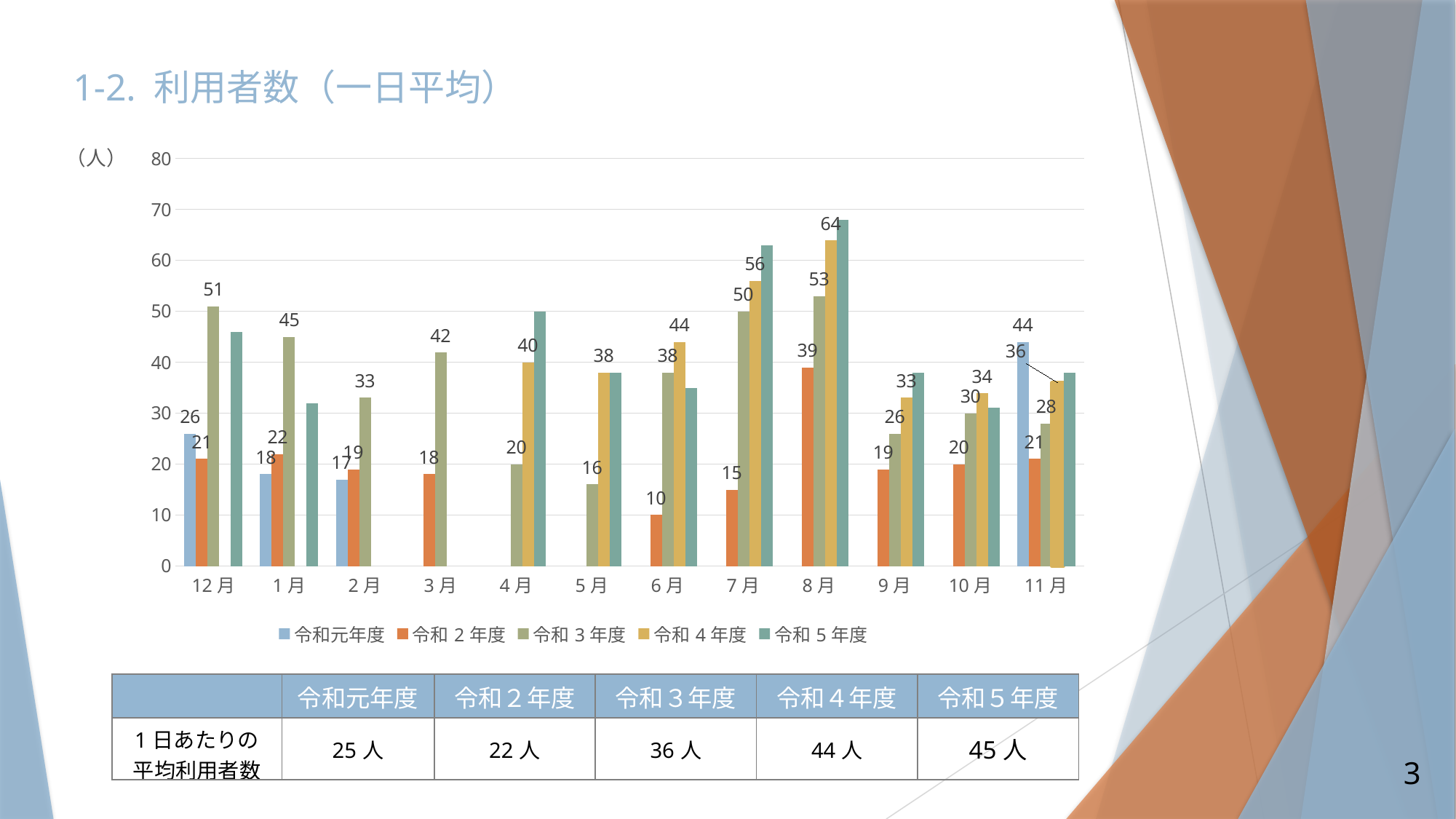
Is the value for 令和5年度 in 8月 greater or less than 60? greater In 12月, which is larger: the 令和元年度 value or the 令和3年度 value? 令和3年度 In which month is the 令和3年度 value highest? 8月 How many months are shown on the x axis of the chart? 12 How many series does the legend list? 5 In 8月, how much larger is the 令和4年度 value than the 令和3年度 value? 11 What is the value for 令和4年度 in 7月? 56 Is the value for 令和5年度 in 10月 greater or less than 40? less What kind of chart is shown on the slide? bar chart What is the value for 令和元年度 in 11月? 44 What is the value for 令和3年度 in 8月? 53 In which month is the 令和2年度 value lowest? 6月